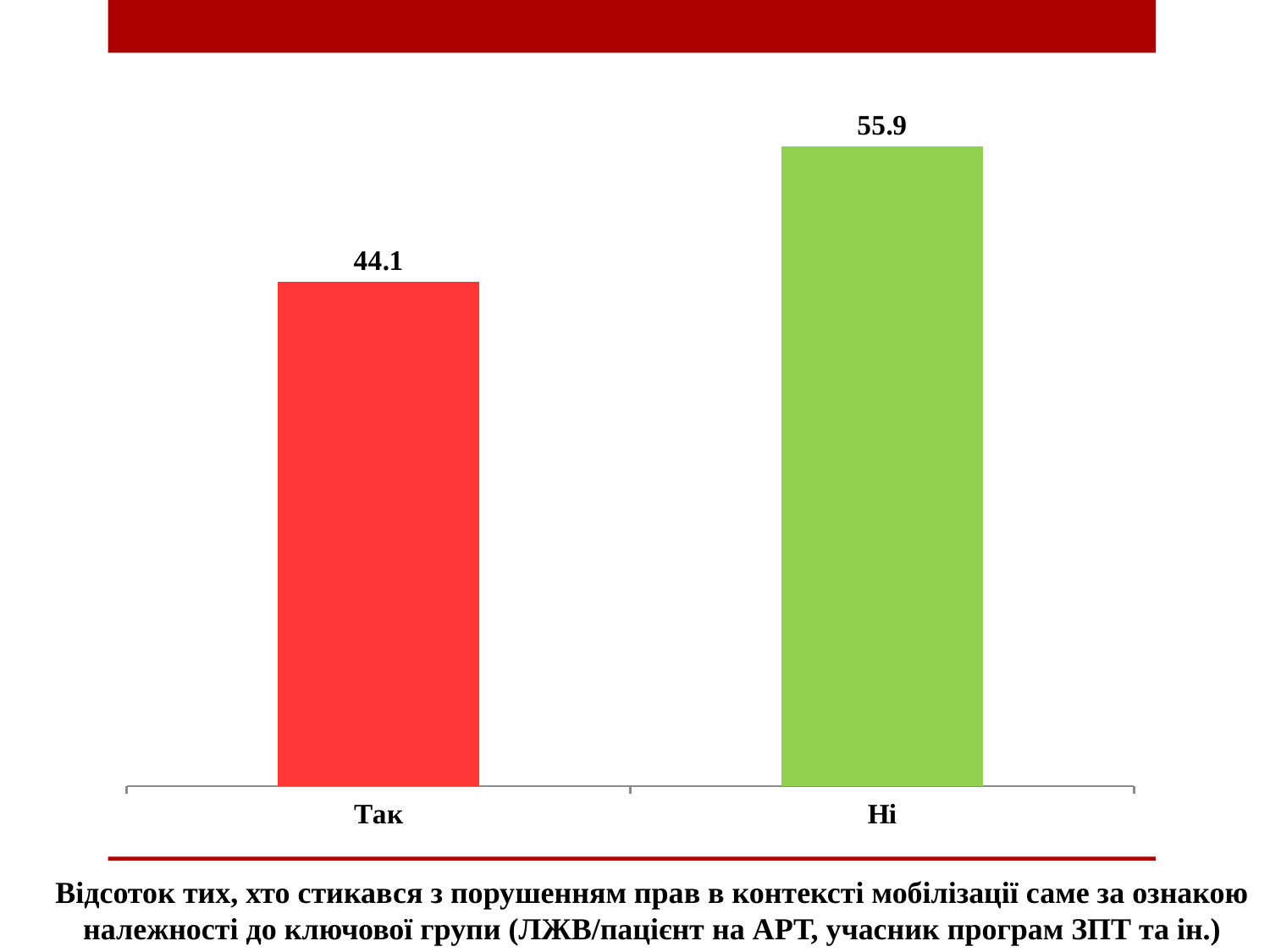
Which category has the highest value? Ні Which is larger, the value for "Так" or the value for "Ні"? Ні How many categories are shown on the chart? 2 What is the value for "Так"? 44.1 What kind of chart is shown on the slide? Bar chart What colour is the bar for "Так"? Red What is the total of the two values shown on the chart? 100 What is the value for "Ні"? 55.9 What colour is the bar for "Ні"? Green What is the difference between the values for "Ні" and "Так"? 11.8 Which category has the lowest value? Так